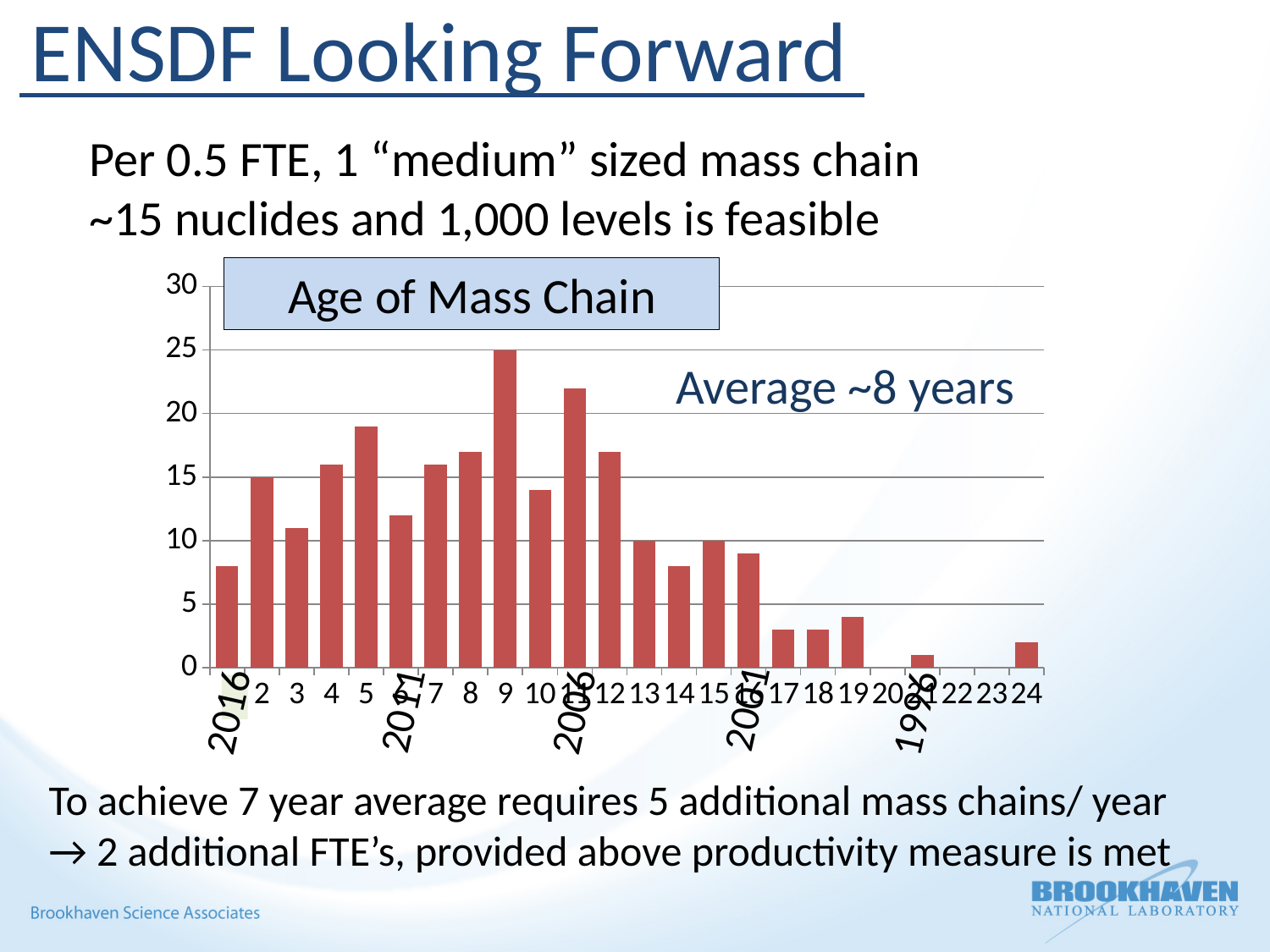
Is the value for category 5 greater or less than 15? greater Which category has the highest bar in the chart? 9 What is the value for category 13 in the chart? 10 What is the title of the chart? Age of Mass Chain Is the value for category 11 greater or less than 20? greater What average age is annotated on the chart? Average ~8 years What kind of chart is shown on the slide? bar chart Which is larger, the value for category 9 or the value for category 11? category 9 Which is larger, the value for category 4 or the value for category 5? category 5 What is the value for category 9 in the chart? 25 How many categories are shown along the x axis of the chart? 24 Is the value for category 17 greater or less than 5? less